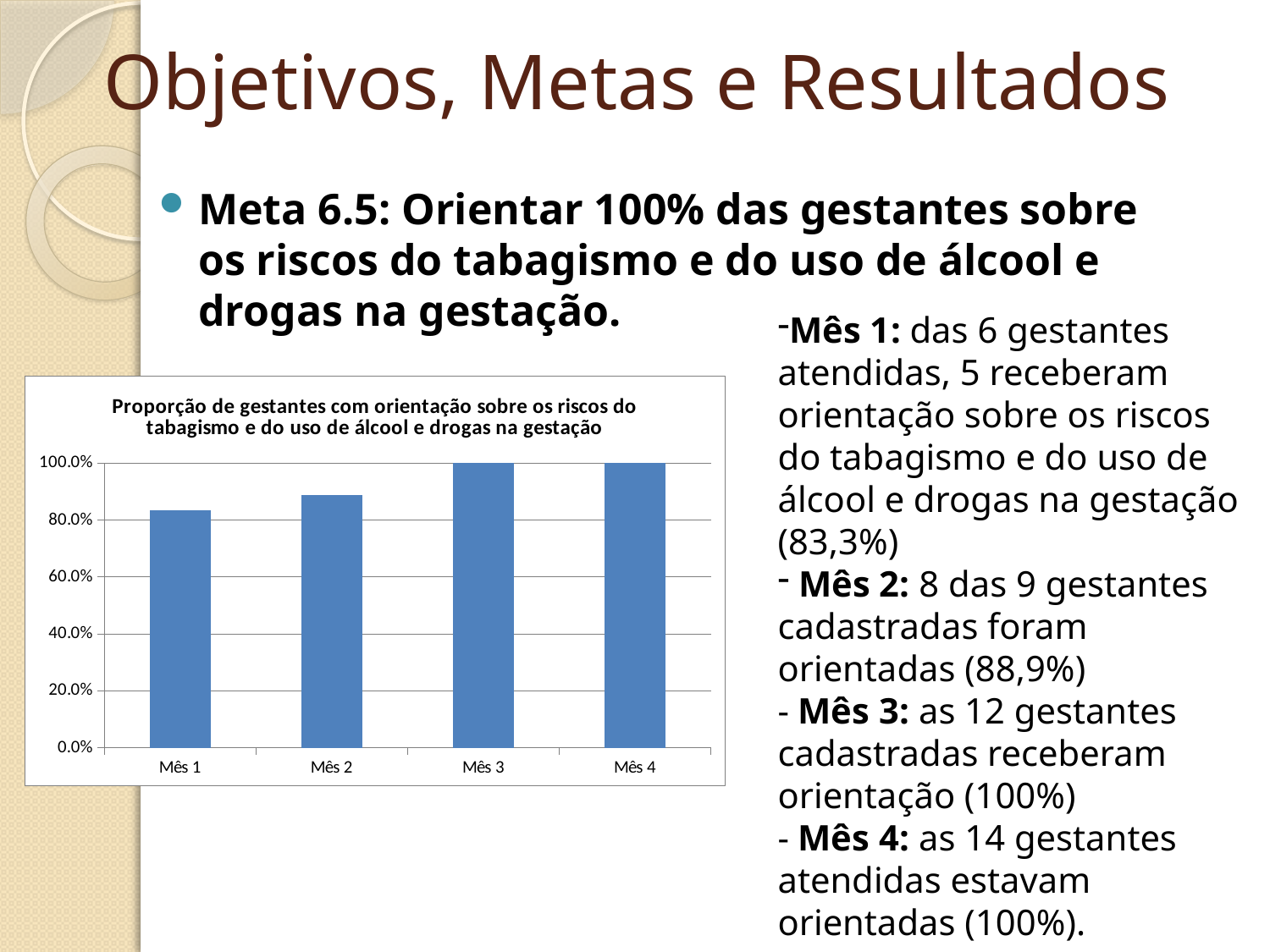
Is the value for Mês 1 greater or less than 60.0%? greater What is the value for Mês 3? 100.0% What is the value for Mês 4? 100.0% Do the values rise or fall from Mês 1 to Mês 4? rise How many months (categories) are plotted on the chart? 4 What is the highest value shown on the chart's vertical axis? 100.0% Which is larger, the value for Mês 1 or the value for Mês 2? Mês 2 Which month has the lowest value on the chart? Mês 1 What is the title of the chart? Proporção de gestantes com orientação sobre os riscos do tabagismo e do uso de álcool e drogas na gestação Is the value for Mês 2 greater or less than 80.0%? greater Is the value for Mês 1 greater or less than 100.0%? less What kind of chart is shown on the slide? bar chart